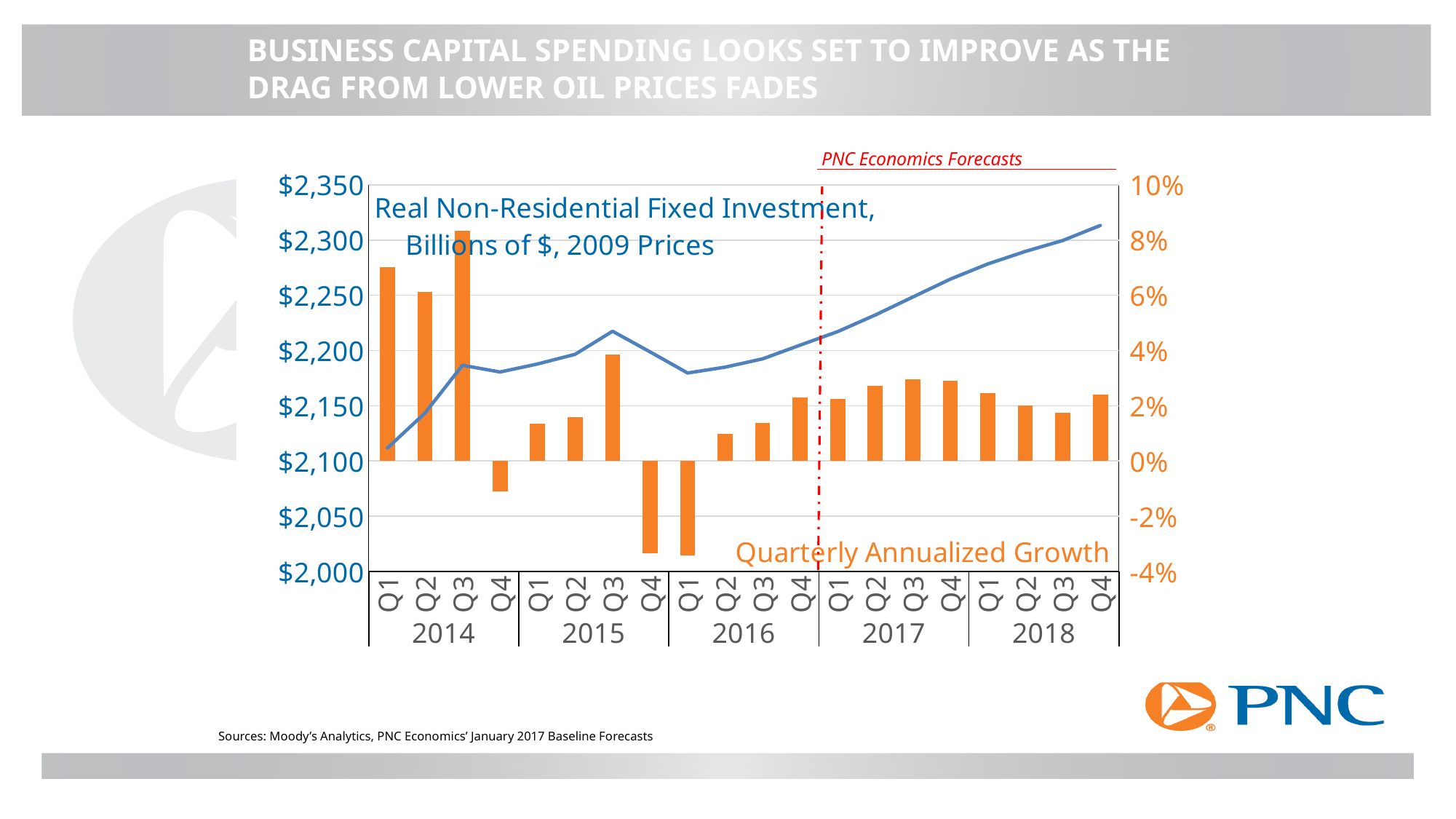
Is the Quarterly Annualized Growth for Q4 2015 greater or less than -2%? less Is the Real Non-Residential Fixed Investment line for Q4 2018 greater or less than $2,300? greater Is the Quarterly Annualized Growth for Q3 2017 greater or less than 2%? greater What kind of chart is shown on the slide? A combination bar and line chart Which has the larger Quarterly Annualized Growth bar, Q1 2014 or Q2 2014? Q1 2014 How many quarters show negative Quarterly Annualized Growth? 3 How many quarterly bars are plotted for Quarterly Annualized Growth? 20 What does the red dashed vertical line on the chart mark the start of? PNC Economics Forecasts Does the Real Non-Residential Fixed Investment line generally rise or fall from 2014 to 2018? Rise Which quarter has the highest Quarterly Annualized Growth bar? Q3 2014